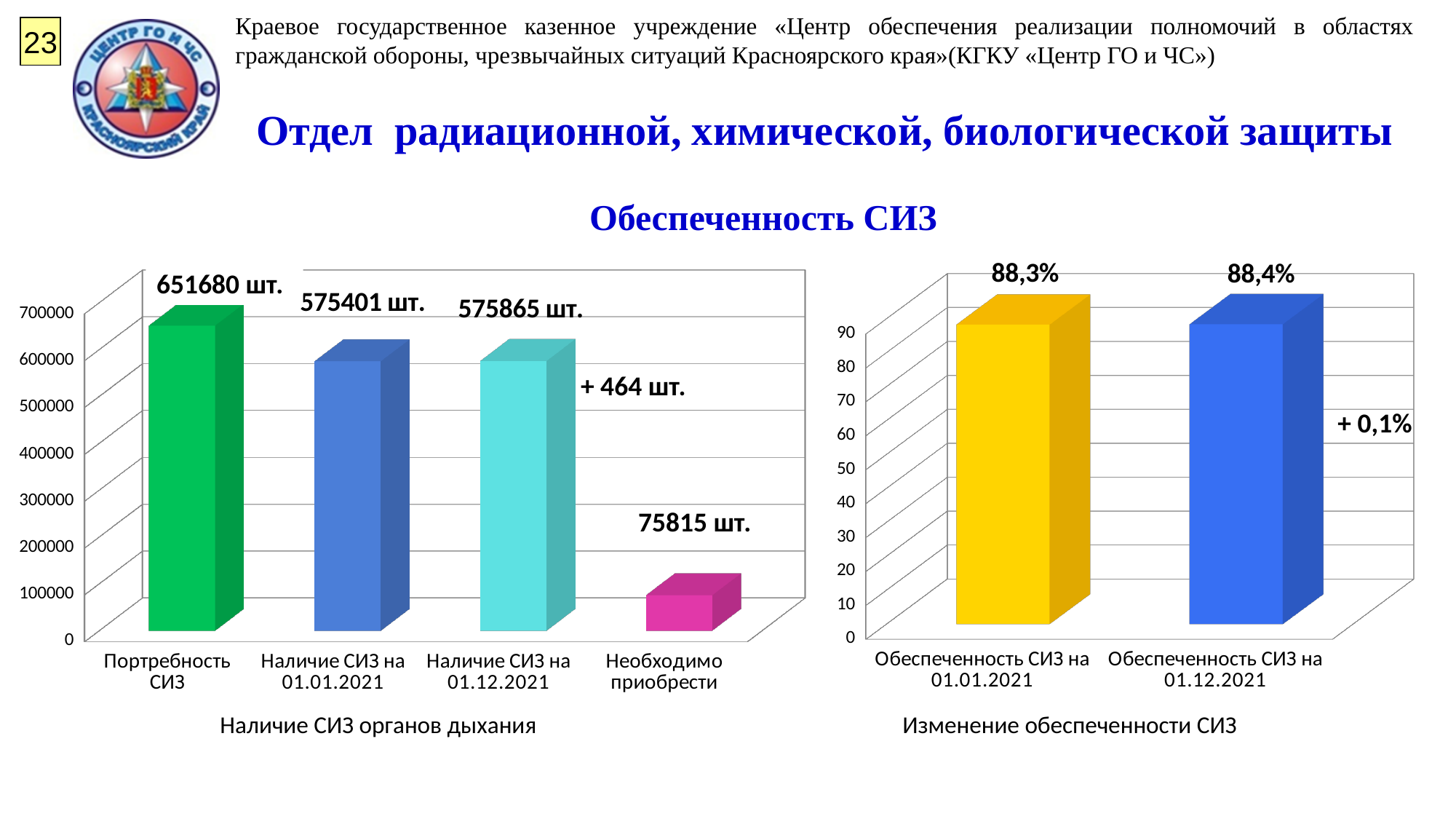
What kind of chart is 'Изменение обеспеченности СИЗ'? bar chart In the chart 'Изменение обеспеченности СИЗ', what is the value for 'Обеспеченность СИЗ на 01.12.2021'? 88,4% In the chart 'Наличие СИЗ органов дыхания', what is the value for 'Необходимо приобрести'? 75815 шт. In the chart 'Наличие СИЗ органов дыхания', is the value for 'Необходимо приобрести' greater or less than 100000? less In the chart 'Изменение обеспеченности СИЗ', what is the value for 'Обеспеченность СИЗ на 01.01.2021'? 88,3% In the chart 'Наличие СИЗ органов дыхания', what is the difference between 'Наличие СИЗ на 01.12.2021' and 'Наличие СИЗ на 01.01.2021'? 464 шт. In the chart 'Наличие СИЗ органов дыхания', what is the value for 'Наличие СИЗ на 01.12.2021'? 575865 шт. In the chart 'Наличие СИЗ органов дыхания', which category has the lowest value? Необходимо приобрести In the chart 'Наличие СИЗ органов дыхания', how many categories are shown? 4 In the chart 'Изменение обеспеченности СИЗ', what is the difference between the value on 01.12.2021 and the value on 01.01.2021? 0,1% In the chart 'Наличие СИЗ органов дыхания', what is the value for 'Портребность СИЗ'? 651680 шт. In the chart 'Наличие СИЗ органов дыхания', which category has the highest value? Портребность СИЗ